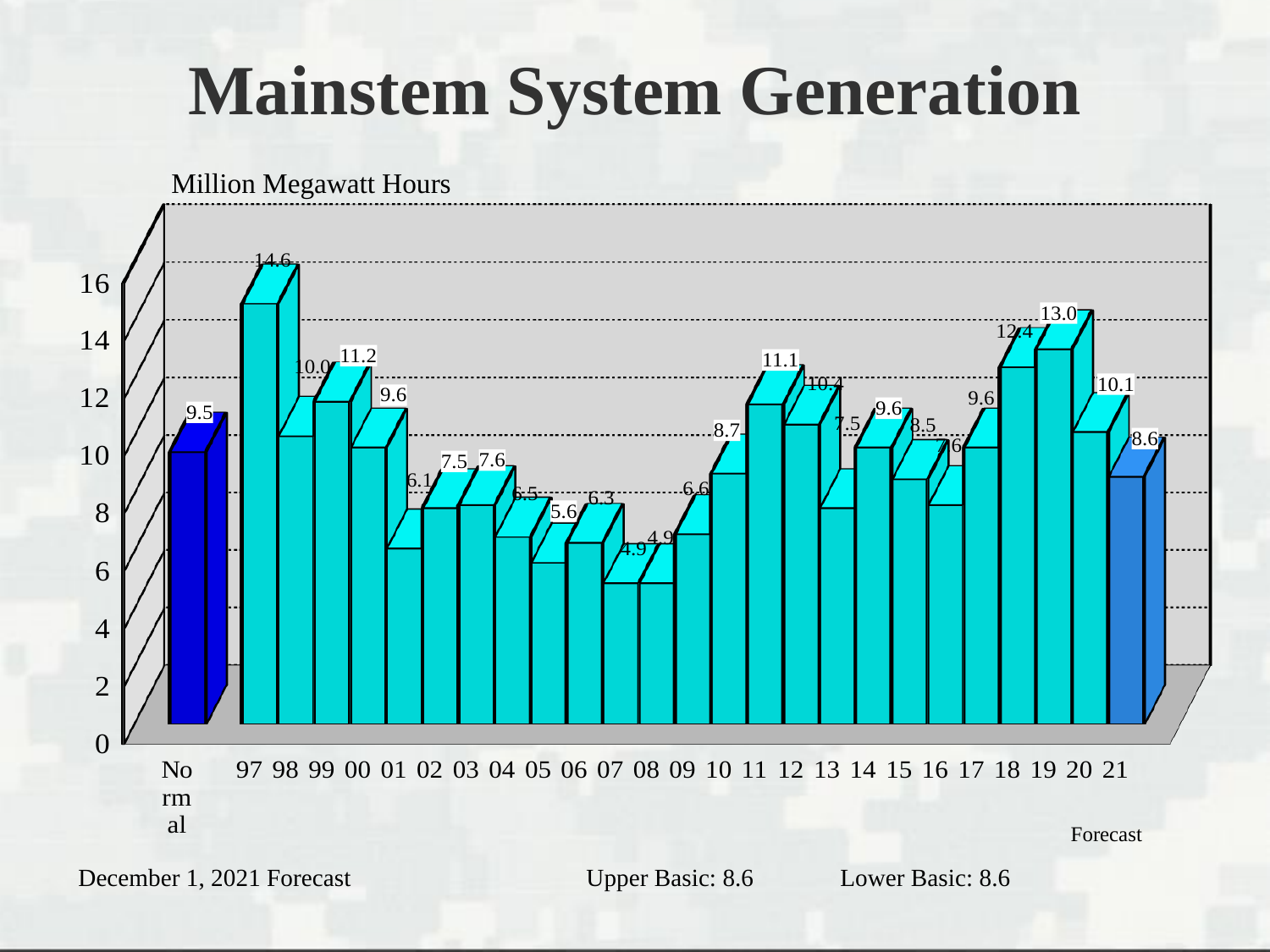
What kind of chart is shown on the slide? bar chart Do the values rise or fall from 07 to 11 in the Mainstem System Generation chart? rise Which year has the highest value in the Mainstem System Generation chart? 97 What is the value for 21 in the Mainstem System Generation chart? 8.6 What is the value for 97 in the Mainstem System Generation chart? 14.6 What is the difference between the values for 18 and 20 in the Mainstem System Generation chart? 2.3 What is the value for the Normal bar in the Mainstem System Generation chart? 9.5 How many bars are plotted in the Mainstem System Generation chart? 26 What is the difference between the values for 97 and 19 in the Mainstem System Generation chart? 1.6 What is the value for 19 in the Mainstem System Generation chart? 13.0 Is the value for 01 in the Mainstem System Generation chart greater or less than 8? less Which is larger in the Mainstem System Generation chart, the value for 11 or the value for 12? 11